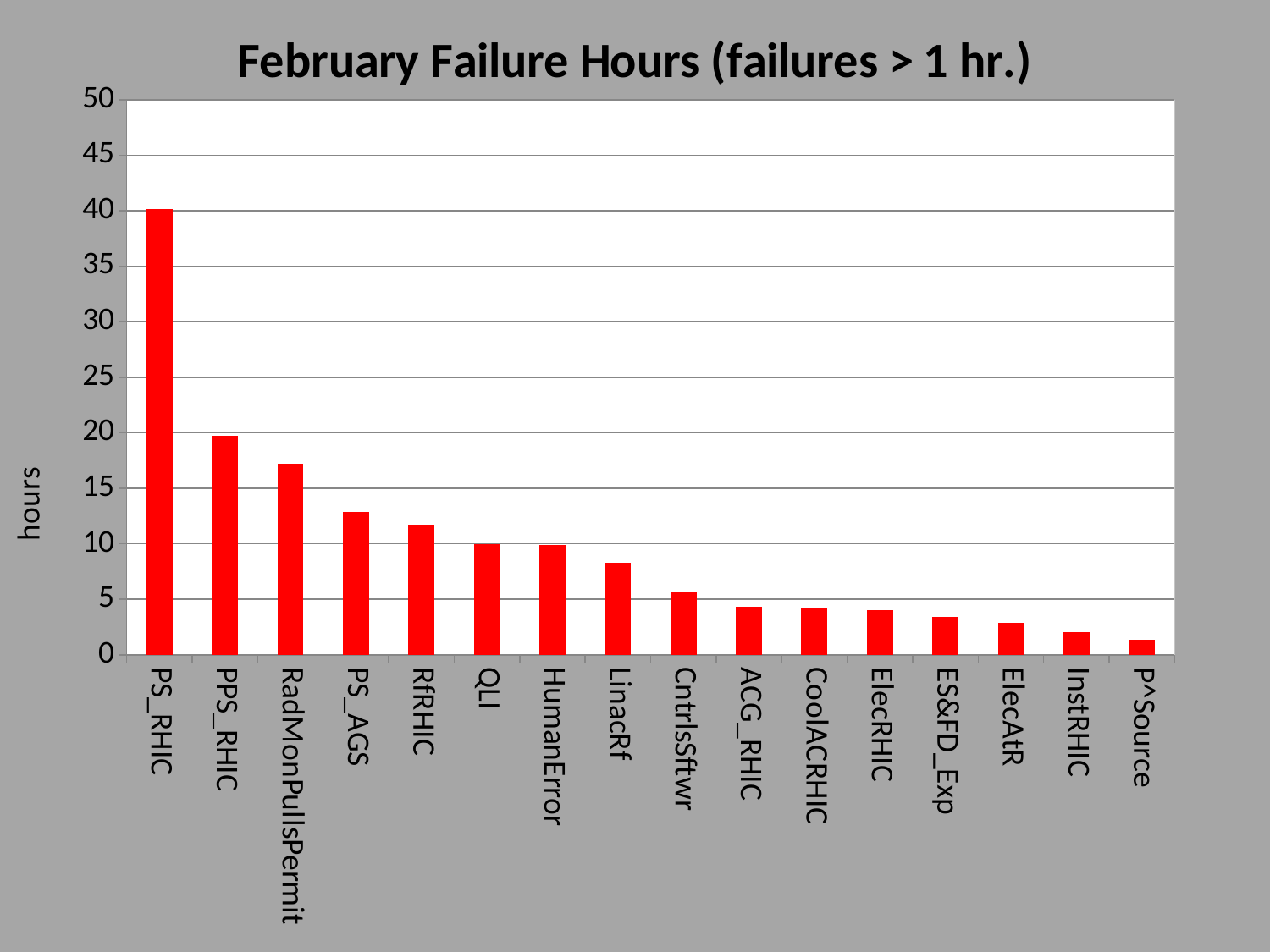
Which category has the highest failure hours? PS_RHIC Which category has the lowest failure hours? P^Source Do the values rise or fall moving from left to right along the x axis? fall Is the value for InstRHIC greater or less than 5? less Is the value for LinacRf greater or less than 10? less What is the title of the chart? February Failure Hours (failures > 1 hr.) Which has more failure hours, RadMonPullsPermit or PS_AGS? RadMonPullsPermit Is the value for PS_RHIC greater or less than 35? greater How many categories are plotted on the x axis? 16 What kind of chart is shown on the slide? bar chart